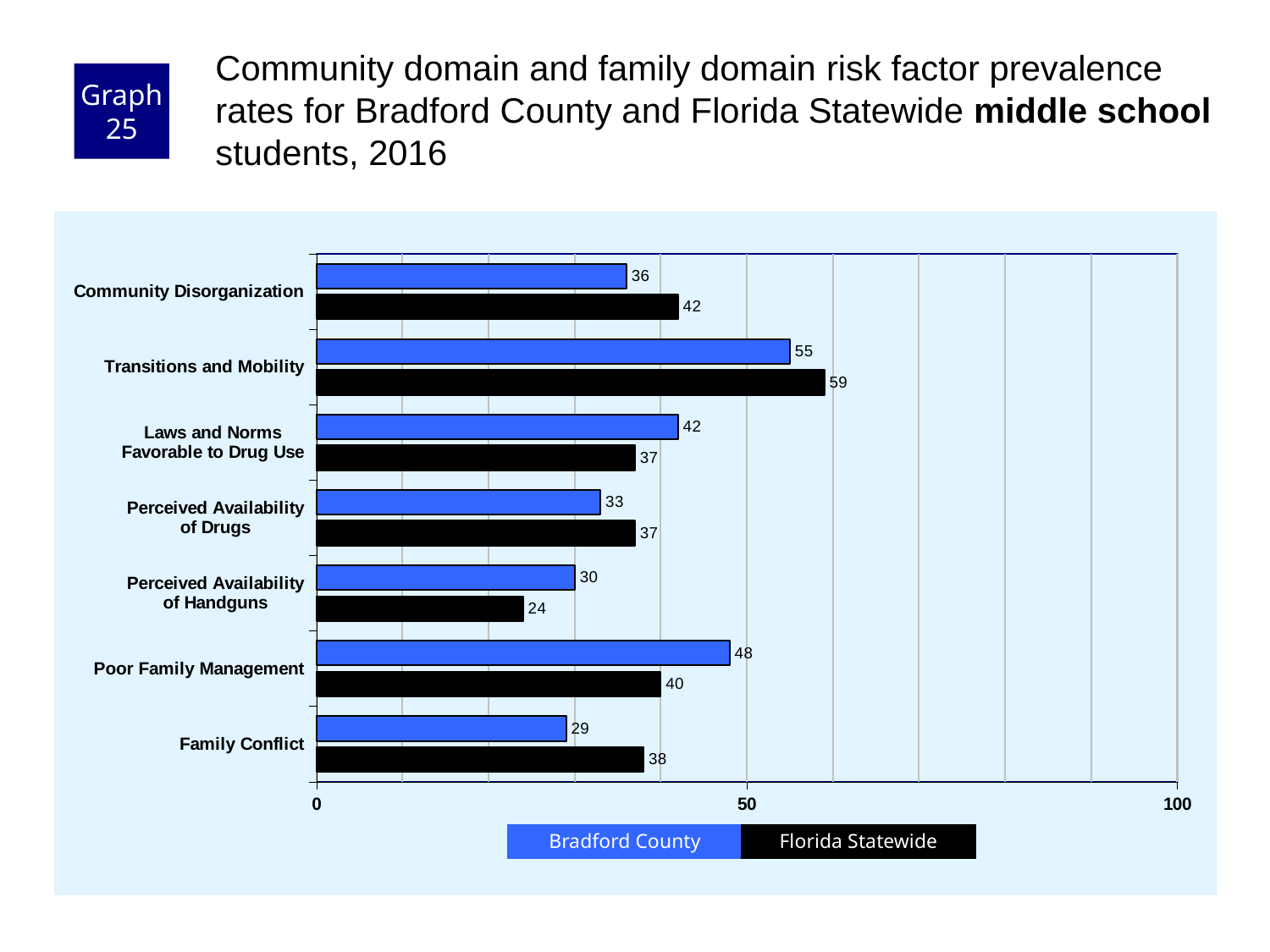
Which series is shown in black? Florida Statewide Which risk factor has the highest Florida Statewide value? Transitions and Mobility What kind of chart is shown on the slide? bar chart What is the Florida Statewide value for Family Conflict? 38 What is the Bradford County value for Perceived Availability of Handguns? 30 How many series does the legend list? 2 How many risk factor categories are shown on the chart? 7 What is the difference between the Florida Statewide and Bradford County values for Community Disorganization? 6 What is the Bradford County value for Transitions and Mobility? 55 Which risk factor has the lowest Bradford County value? Family Conflict Is the Florida Statewide value for Transitions and Mobility greater or less than 50? greater For Poor Family Management, which is larger: the Bradford County value or the Florida Statewide value? Bradford County